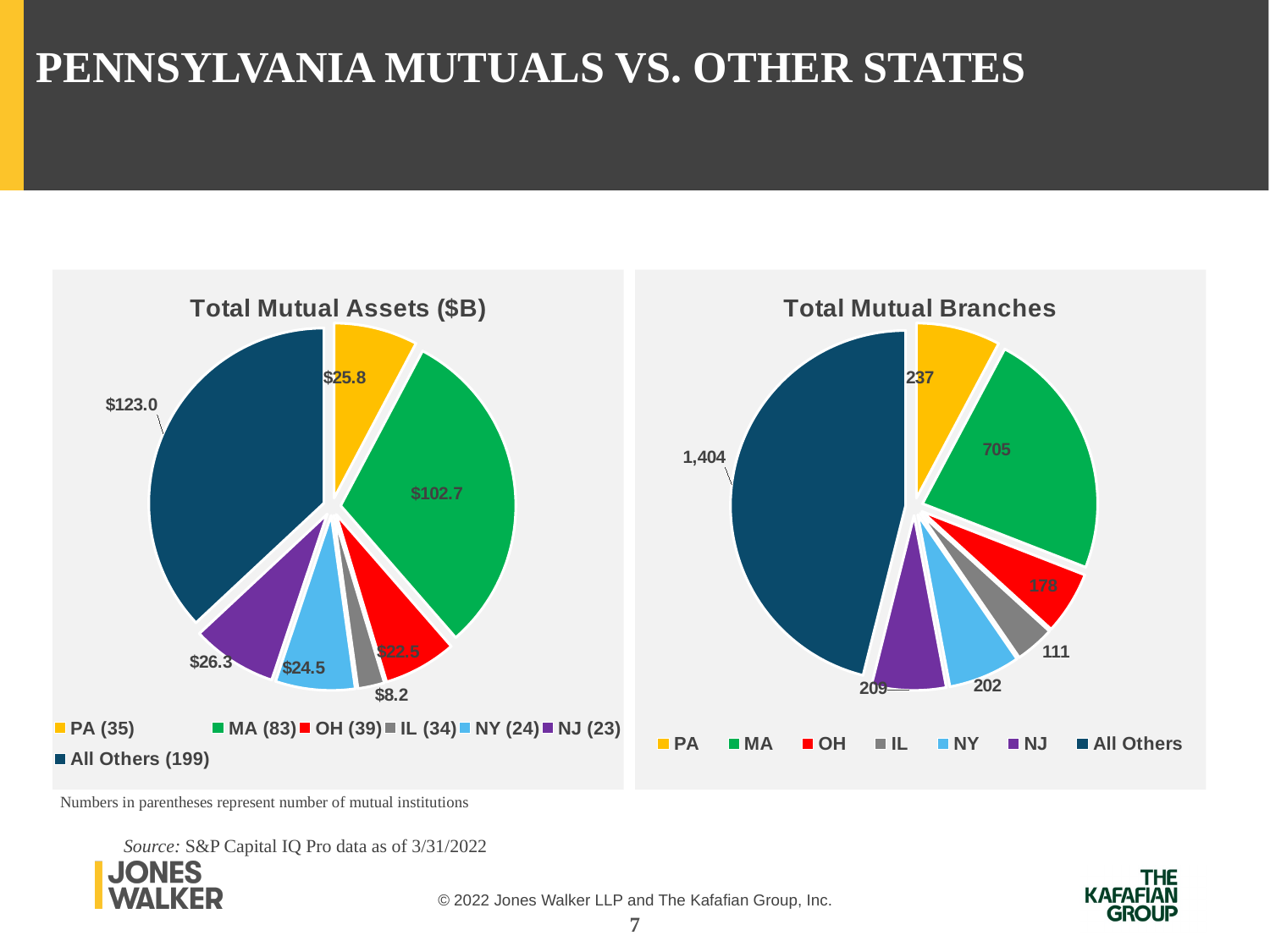
In the Total Mutual Assets ($B) chart, what is the value for MA? $102.7 In the Total Mutual Branches chart, which is larger, NJ or NY? NJ In the Total Mutual Branches chart, which state (excluding All Others) has the most branches? MA In the Total Mutual Assets ($B) chart legend, how many mutual institutions are listed for OH? 39 In the Total Mutual Branches chart, what share of all branches does All Others represent? 46.1% In the Total Mutual Assets ($B) chart, which category has the smallest slice? IL In the Total Mutual Assets ($B) chart, how much larger is All Others than MA? $20.3 How many slices does the Total Mutual Assets ($B) pie chart have? 7 What type of chart is the Total Mutual Branches chart? Pie chart In the Total Mutual Branches chart, how many branches does PA have? 237 In the Total Mutual Assets ($B) chart, which category has the largest slice? All Others In the Total Mutual Branches chart, what is the difference between MA and PA? 468